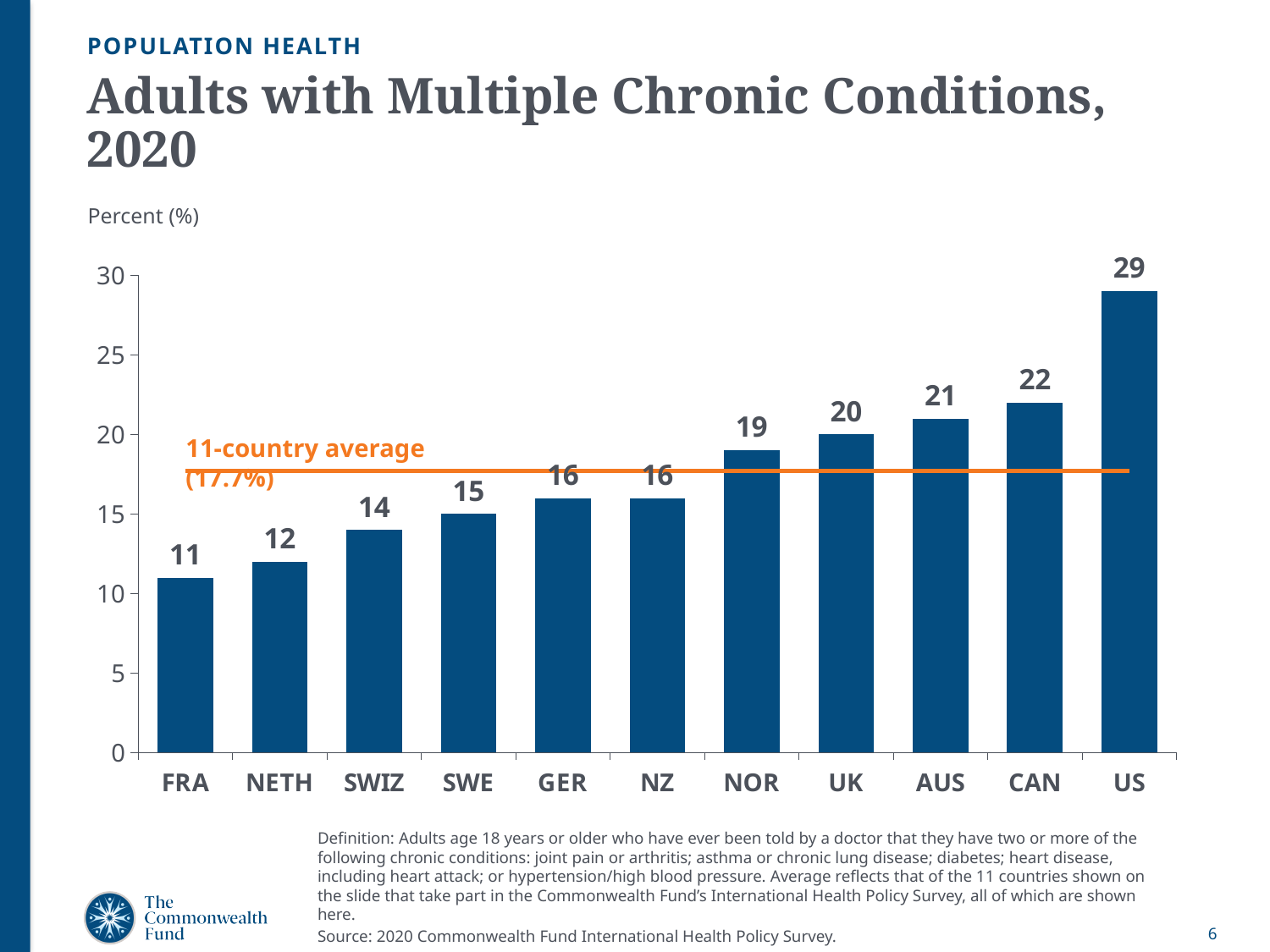
Which is larger, the value for NOR or the value for SWIZ? NOR What is the value for NETH? 12 How many countries are shown on the chart? 11 What is the 11-country average shown by the orange line? 17.7% What is the value for GER? 16 Which country has the highest value? US What kind of chart is shown on the slide? bar chart Which country has the lowest value? FRA What is the difference between the values for CAN and SWE? 7 Is the value for AUS greater or less than 20? greater What is the value for the US? 29 What is the difference between the values for the US and FRA? 18